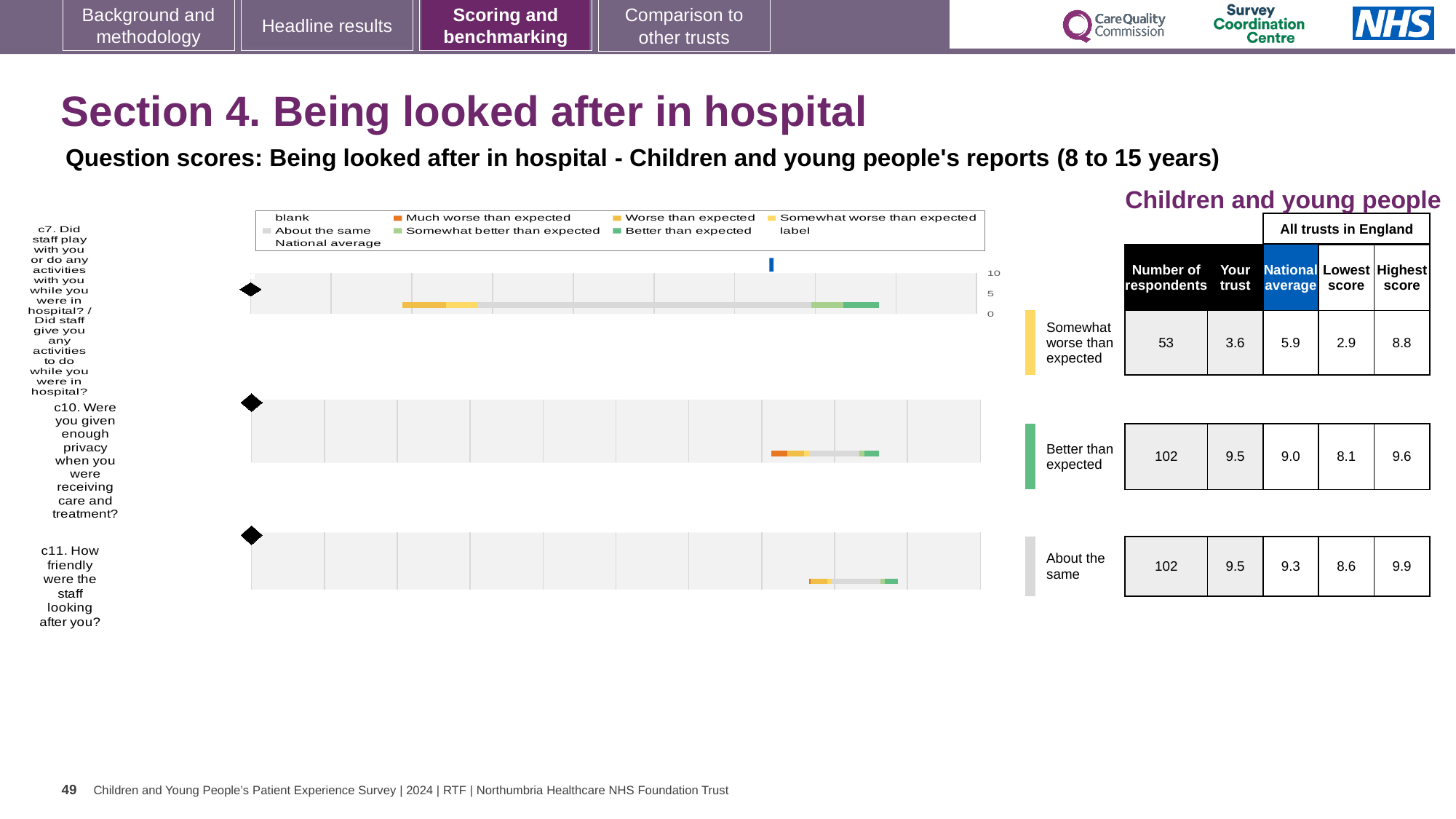
What is the highest score among all trusts in England for c11 (How friendly were the staff looking after you?)? 9.9 What is the national average score for c7 (Did staff play with you or do any activities with you while you were in hospital?)? 5.9 Which benchmark category is the trust's score for c7 placed in? Somewhat worse than expected How many questions are plotted on this slide? 3 How many respondents answered question c7? 53 For c10, which is larger: the 'Your trust' score or the national average? Your trust What is the difference between the highest and lowest scores for c11? 1.3 What is the lowest score among all trusts in England for c11? 8.6 Which question has the lowest 'Your trust' score? c7 What is the difference between the national average and the 'Your trust' score for c7? 2.3 Which benchmark category is the trust's score for c10 placed in? Better than expected What is the 'Your trust' score for c10 (Were you given enough privacy when you were receiving care and treatment?)? 9.5